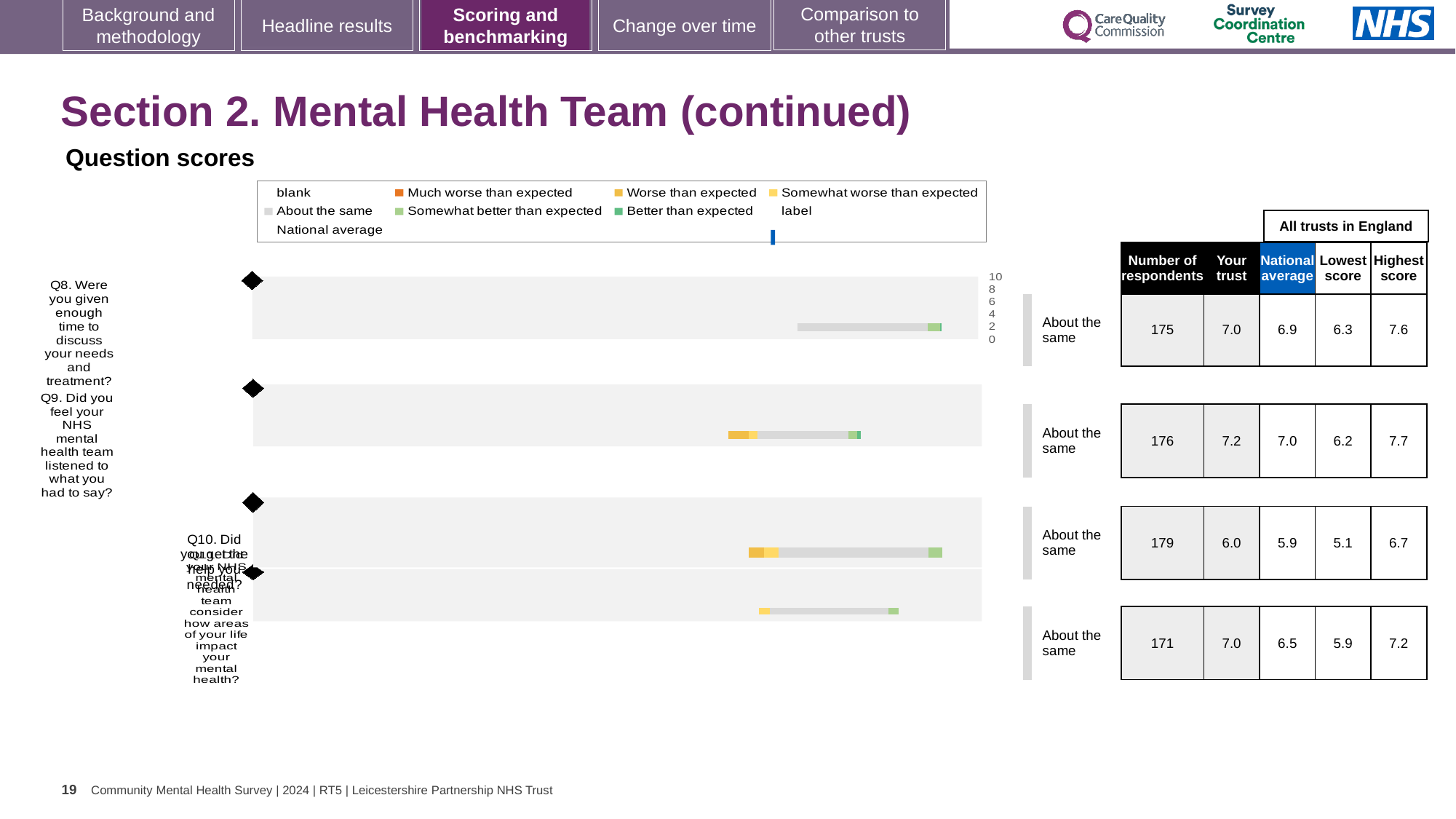
How many question bars are plotted in the question scores chart? 4 In the table beside the chart, how many respondents are listed for Q8? 175 What benchmark category is shown next to the bar for Q8 (Were you given enough time to discuss your needs and treatment?)? About the same What colour is used in the legend for 'Better than expected'? green In the table beside the chart, what is the highest score for the bottom (fourth) question? 7.2 Which question has the highest 'Your trust' score in the table beside the chart? Q9 In the table beside the chart, what is the national average for Q10 (Did you get the help you needed?)? 5.9 In the table beside the chart, what is the 'Your trust' score for Q9 (Did you feel your NHS mental health team listened to what you had to say?)? 7.2 For Q9, what is the difference between the highest score and the lowest score shown in the table? 1.5 For Q8, which is larger: the 'Your trust' score or the national average? Your trust What type of chart is used to show the question scores on this slide? bar chart Which question has the lowest national average in the table beside the chart? Q10